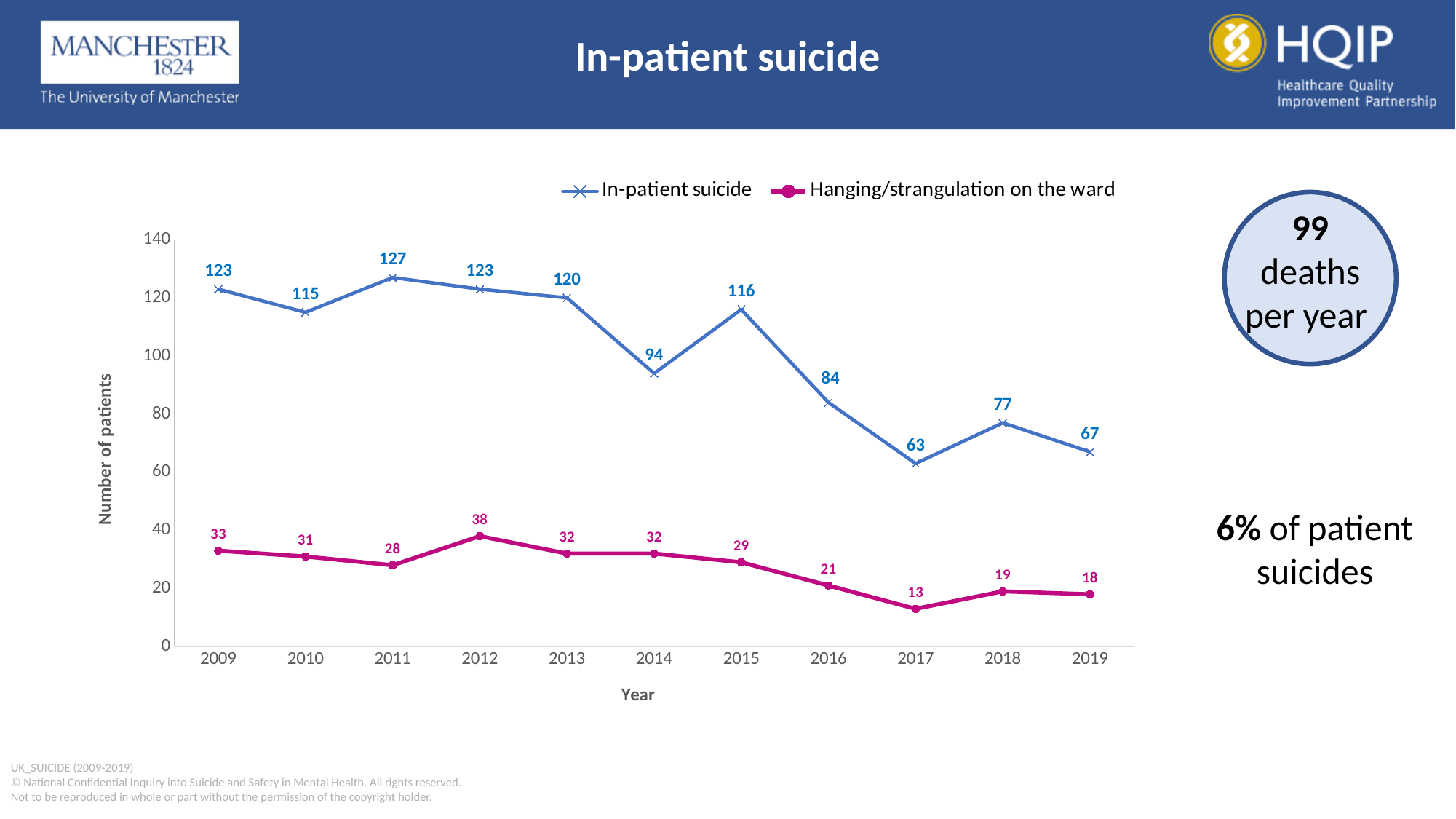
What is the value for Hanging/strangulation on the ward in 2017? 13 What is the difference between the In-patient suicide values for 2009 and 2019? 56 In which year is the Hanging/strangulation on the ward series lowest? 2017 How many years are shown on the x axis? 11 What is the label of the y axis? Number of patients Does the In-patient suicide series generally rise or fall from 2009 to 2019? fall Which is larger, the Hanging/strangulation on the ward value for 2012 or for 2015? 2012 What kind of chart is shown on the slide? line chart How many series does the legend list? 2 Is the In-patient suicide value for 2014 greater or less than 100? less What is the value for In-patient suicide in 2011? 127 In which year is the In-patient suicide series highest? 2011